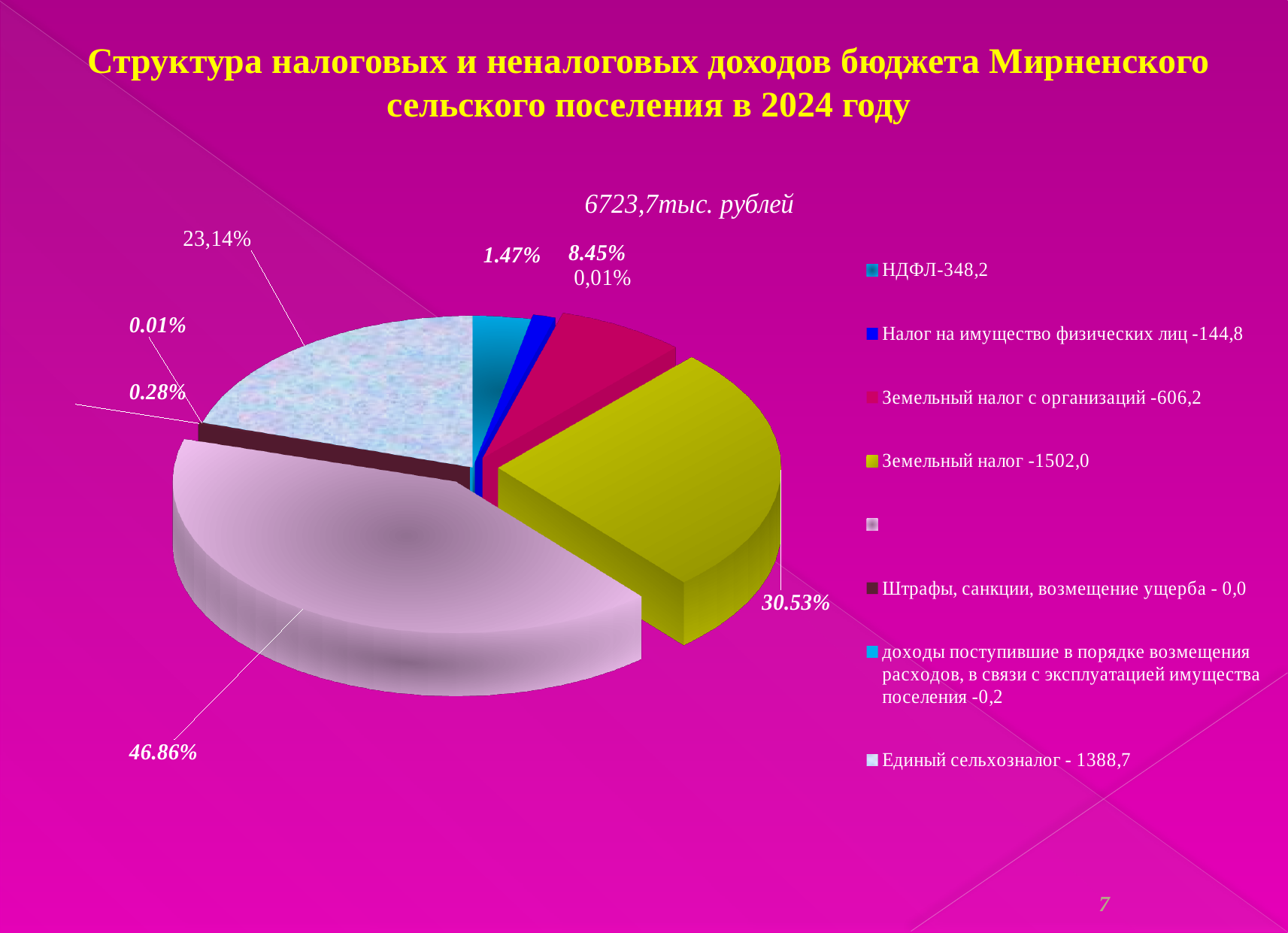
What value is given in the legend for НДФЛ? 348,2 What value is given in the legend for Штрафы, санкции, возмещение ущерба? 0,0 What is the difference between the legend values for Земельный налог (1502,0) and Единый сельхозналог (1388,7)? 113,3 What total amount is printed above the pie chart? 6723,7тыс. рублей What is the difference between the legend values for НДФЛ (348,2) and Налог на имущество физических лиц (144,8)? 203,4 What value is given in the legend for Земельный налог? 1502,0 What type of chart is shown on the slide? pie chart What value is given in the legend for Единый сельхозналог? 1388,7 What value is given in the legend for Налог на имущество физических лиц? 144,8 What percentage label is shown next to the yellow slice of the pie? 30.53% Which has the larger legend value: Земельный налог or Единый сельхозналог? Земельный налог What is the largest percentage label shown on the pie chart? 46.86%